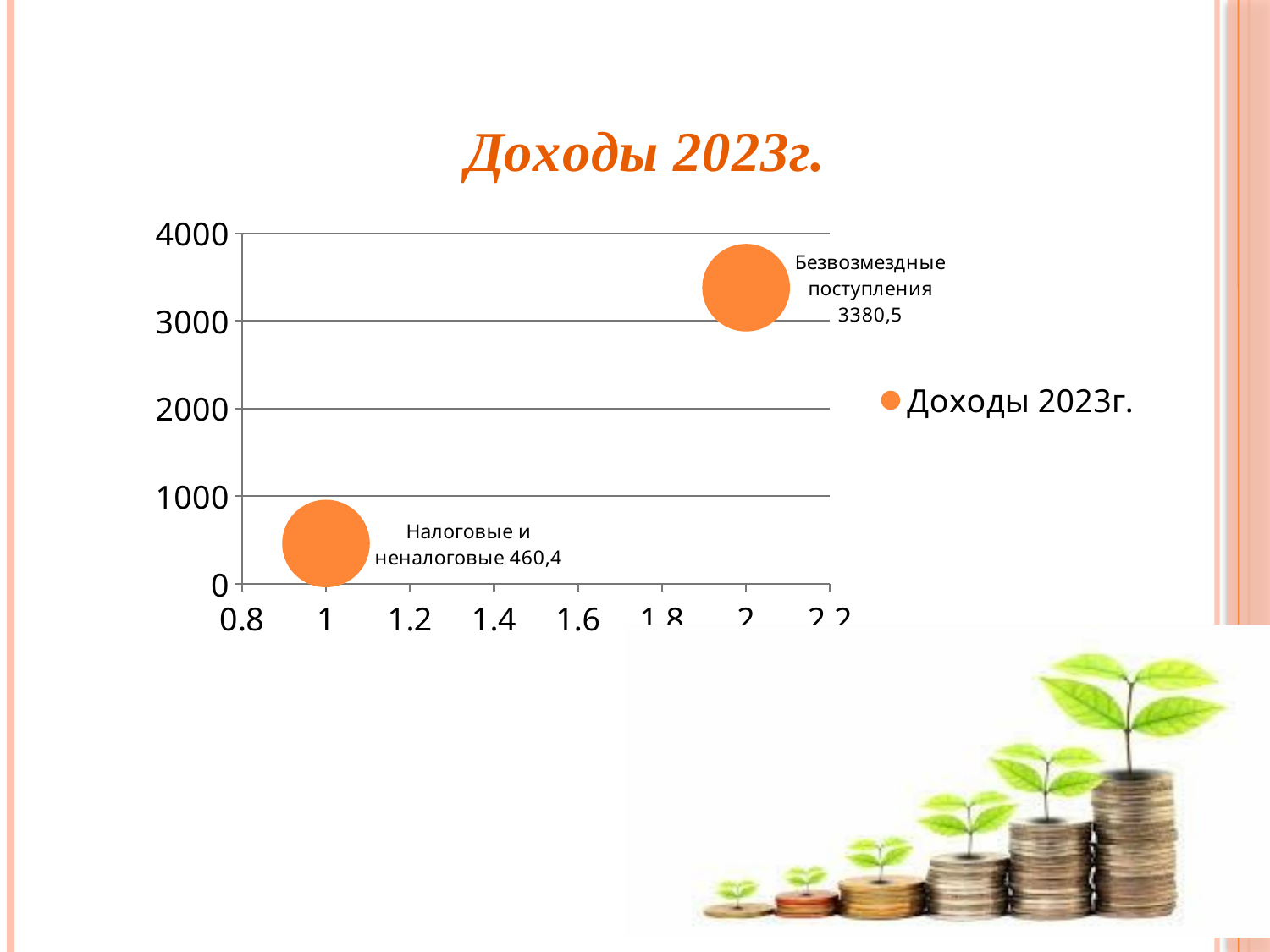
Which category has the highest value? Безвозмездные поступления What is the value for Безвозмездные поступления? 3380,5 How many data points are plotted on the chart? 2 Which is larger: Безвозмездные поступления or Налоговые и неналоговые? Безвозмездные поступления What kind of chart is shown on the slide? bubble chart What is the title of the chart? Доходы 2023г. Which category has the lowest value? Налоговые и неналоговые Is the value for Налоговые и неналоговые greater or less than 1000? less Is the value for Безвозмездные поступления greater or less than 3000? greater What is the difference between the values for Безвозмездные поступления and Налоговые и неналоговые? 2920,1 How many series does the legend list? 1 What is the value for Налоговые и неналоговые? 460,4